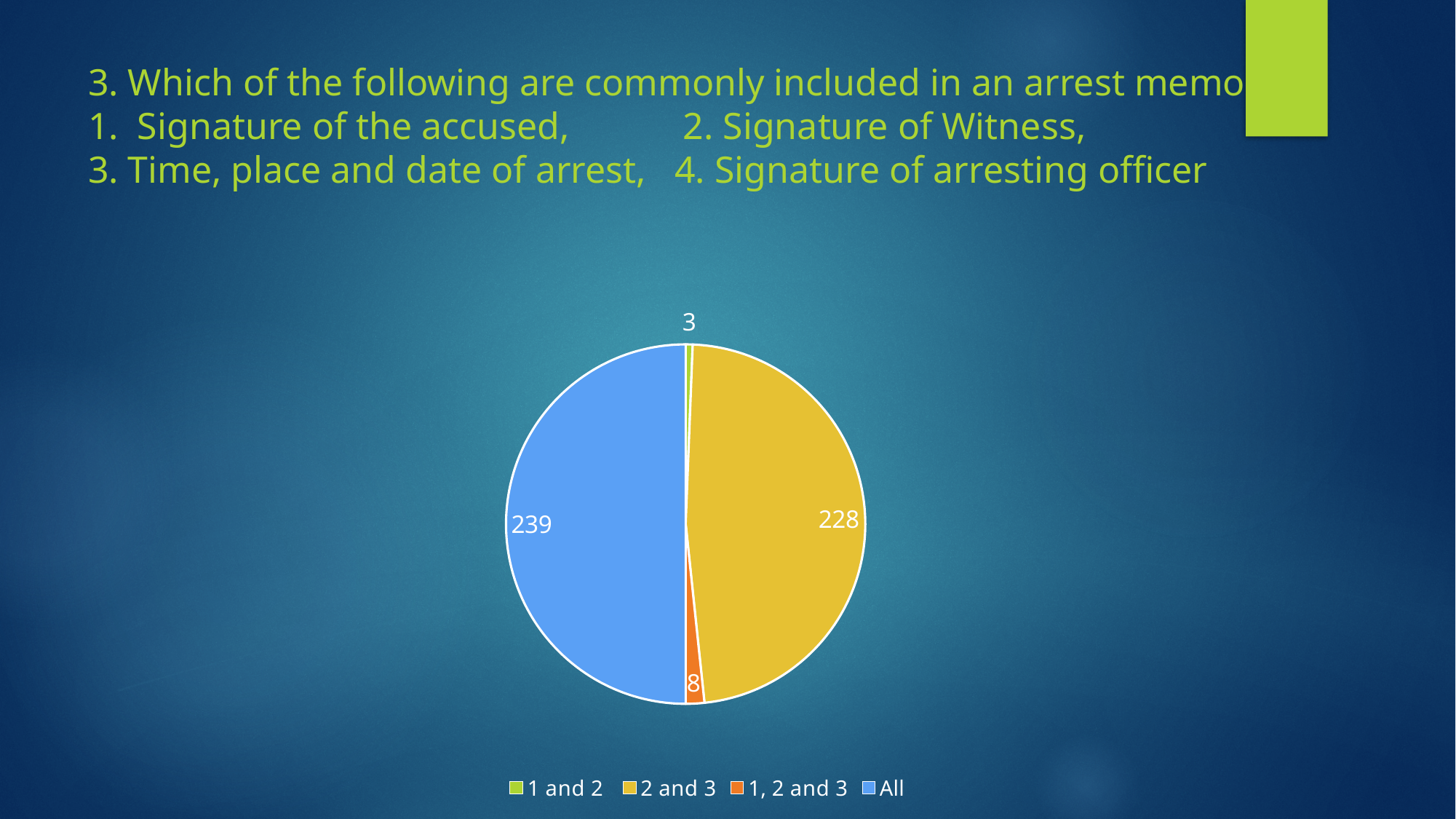
Which slice has the largest value? All What is the value for the "1 and 2" slice? 3 How many slices does the pie chart have? 4 What is the value for the "1, 2 and 3" slice? 8 What is the value for the "2 and 3" slice? 228 What is the value for the "All" slice? 239 What share of the pie does the "All" slice represent? 50% What type of chart is shown on the slide? pie chart Which slice has the smallest value? 1 and 2 What colour is the "2 and 3" slice? yellow Which is larger, the "1, 2 and 3" slice or the "1 and 2" slice? 1, 2 and 3 What is the difference between the "All" slice and the "2 and 3" slice? 11